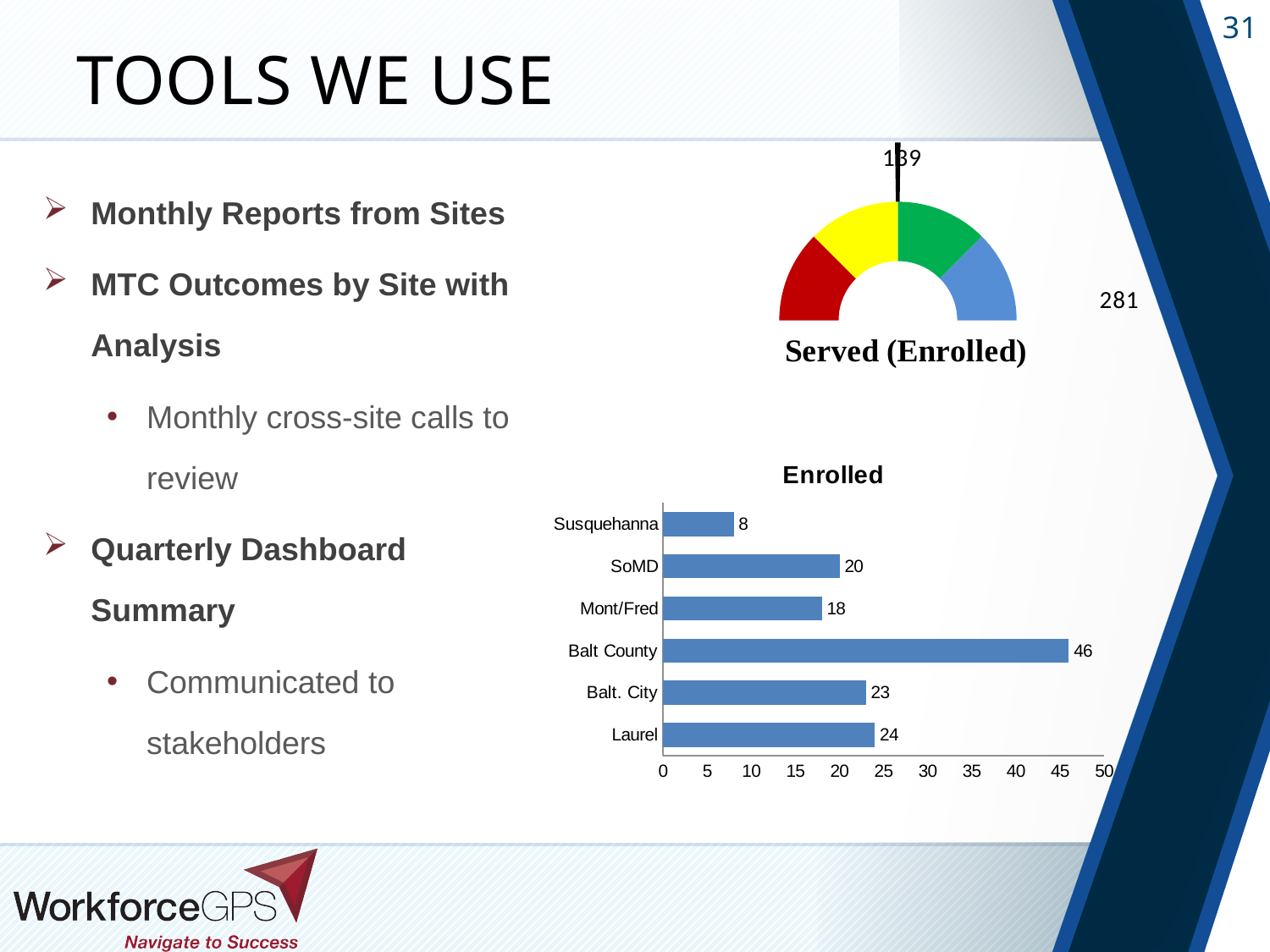
In the Enrolled chart, which is larger, Balt. City or Mont/Fred? Balt. City In the Enrolled chart, what is the value for Balt County? 46 In the Enrolled chart, what is the difference between Balt County and SoMD? 26 What is the title of the gauge chart at the top right of the slide? Served (Enrolled) In the Enrolled chart, what is the value for Laurel? 24 In the Enrolled chart, what is the value for Susquehanna? 8 In the Enrolled chart, which site has the lowest value? Susquehanna What kind of chart is the Enrolled chart? Bar chart In the Enrolled chart, how many sites are shown? 6 In the Enrolled chart, what is the value for Mont/Fred? 18 In the Enrolled chart, what is the total of Balt. City and Laurel? 47 In the Enrolled chart, which site has the highest value? Balt County